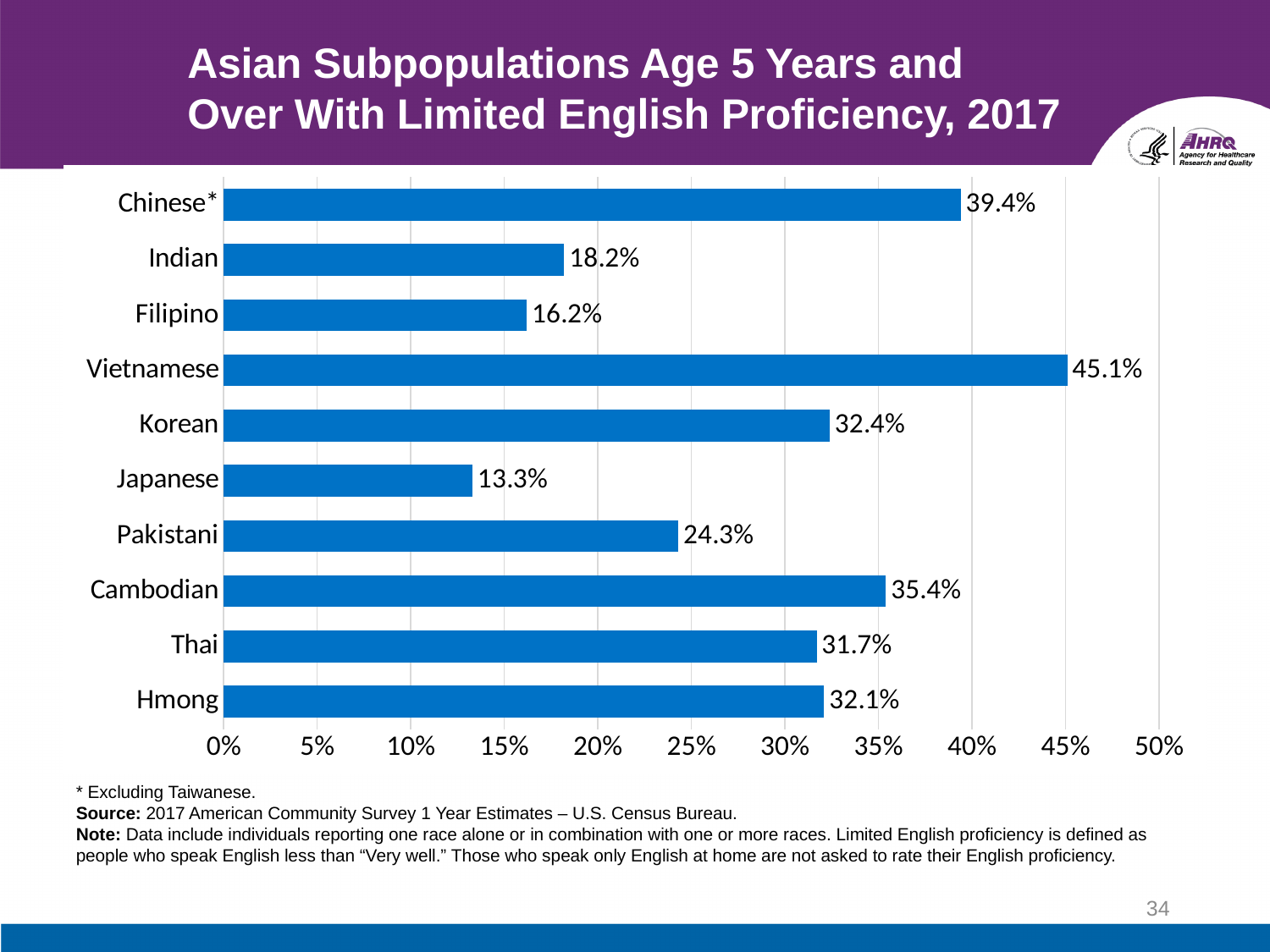
Which is larger, the value for Korean or the value for Pakistani? Korean What kind of chart is shown on the slide? Bar chart Which subpopulation has the highest percentage with limited English proficiency? Vietnamese Is the value for Thai greater or less than 30%? greater How many subpopulations are shown in the chart? 10 What is the difference between the values for Vietnamese and Chinese*? 5.7% What is the value for Japanese? 13.3% What is the value for Vietnamese? 45.1% What is the value for Cambodian? 35.4% What is the difference between the values for Indian and Filipino? 2.0% What is the title of the chart? Asian Subpopulations Age 5 Years and Over With Limited English Proficiency, 2017 Which subpopulation has the lowest percentage with limited English proficiency? Japanese